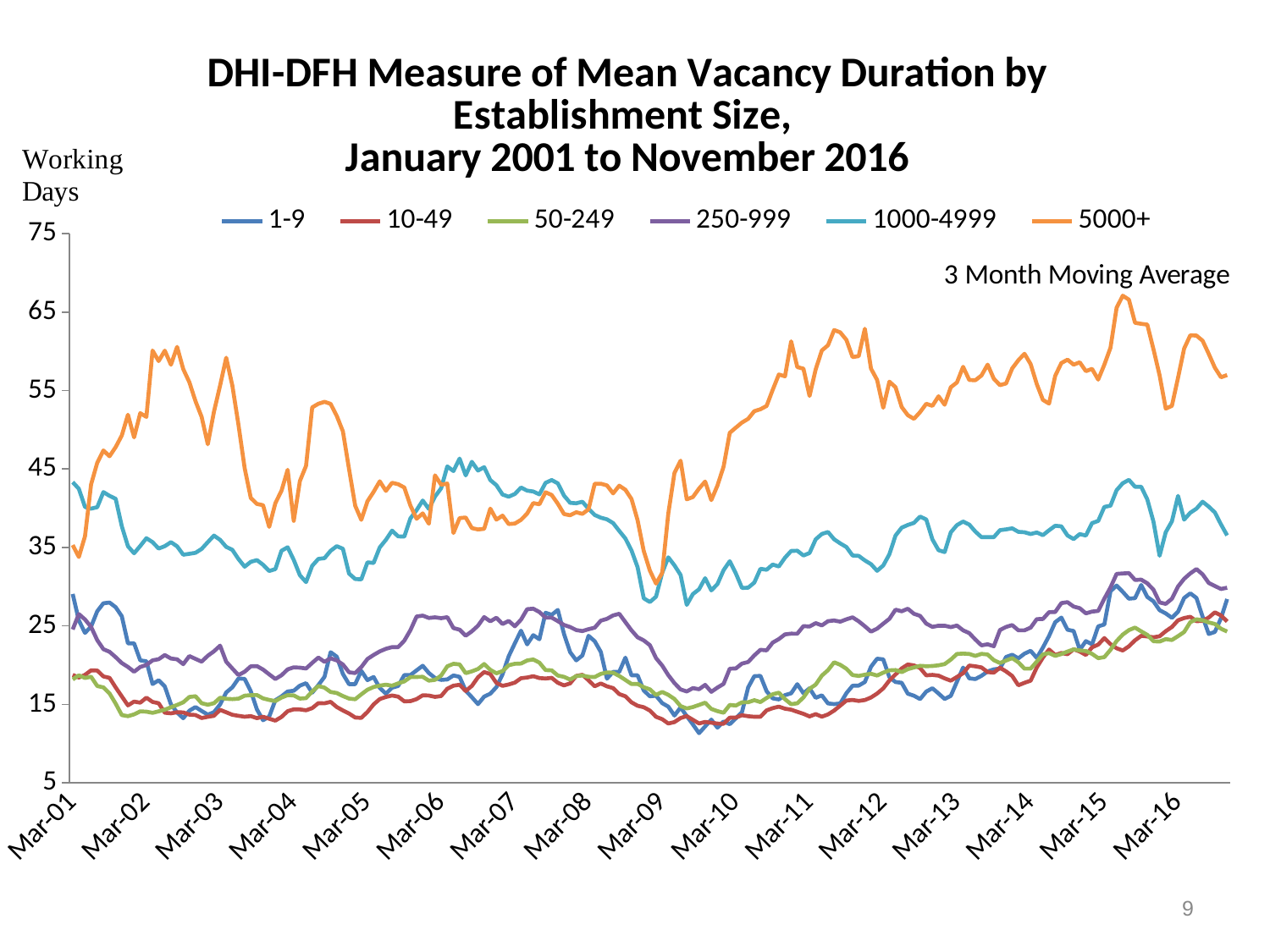
Is the value for the 10-49 series at Mar-10 greater or less than 15? less What kind of chart is shown on the slide? line chart Is the value for the 1000-4999 series at Mar-01 greater or less than 35? greater How many series does the legend list? 6 How many date labels are shown on the x axis? 16 Does the 5000+ series rise or fall between Mar-09 and Mar-11? rise Is the value for the 5000+ series at Mar-15 greater or less than 55? greater What unit is shown on the vertical axis label? Working Days What is the title of the chart? DHI-DFH Measure of Mean Vacancy Duration by Establishment Size, January 2001 to November 2016 At Mar-16, which is larger: the 5000+ series or the 1000-4999 series? 5000+